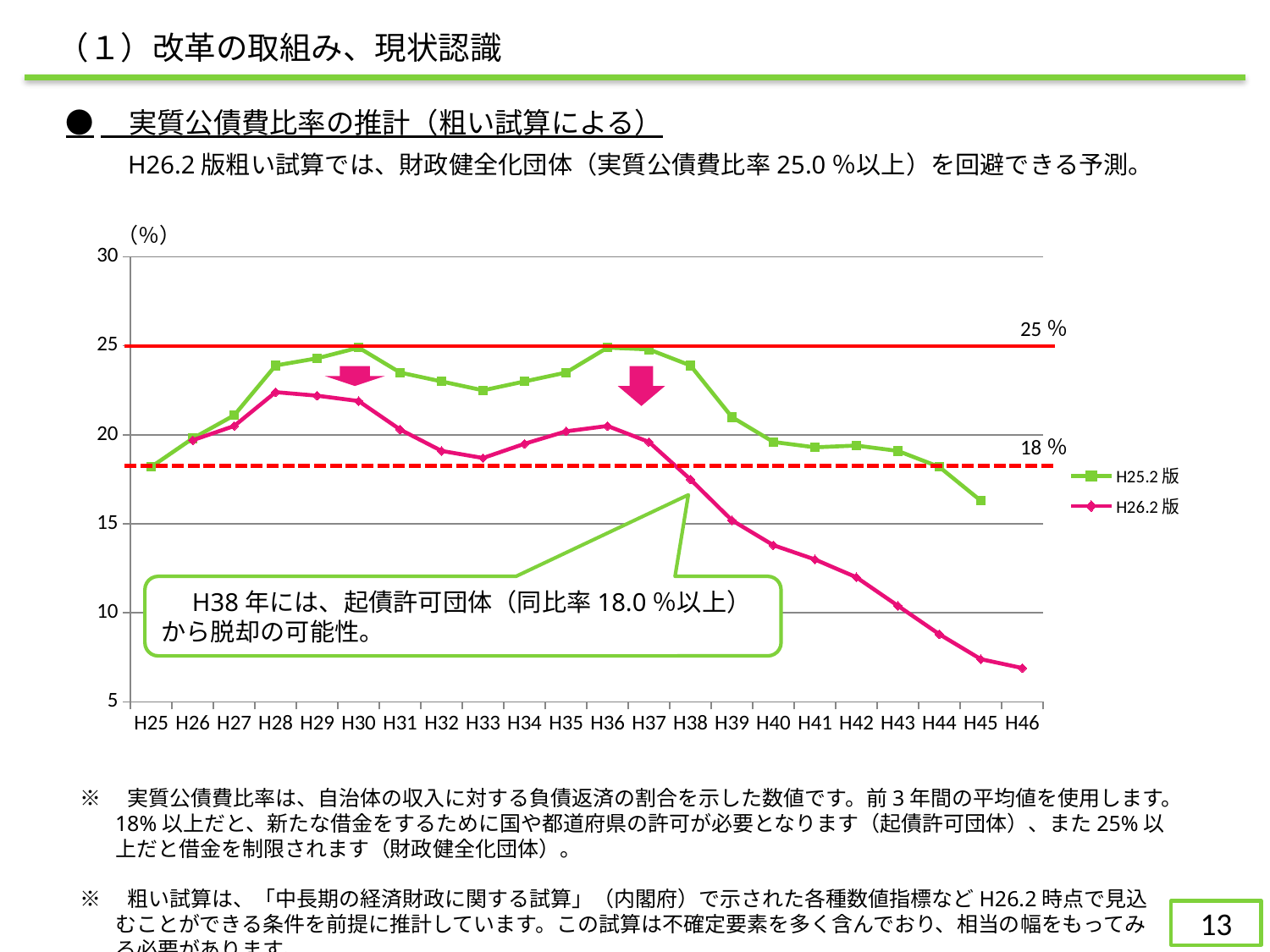
What are the two series named in the chart legend? H25.2版 and H26.2版 What value does the solid red horizontal line in the chart mark? 25% Is the value for H25.2版 at H45 greater or less than 20? less Do the values of the H26.2版 series rise or fall from H38 to H46? fall How many year categories are shown on the x axis of the chart? 22 In which year does the H26.2版 series reach its lowest value? H46 Is the value for H26.2版 at H28 greater or less than 20? greater How many series does the chart legend list? 2 Is the value for H26.2版 at H46 greater or less than 10? less What kind of chart is shown on the slide? line chart At H44, which series has the higher value, H25.2版 or H26.2版? H25.2版